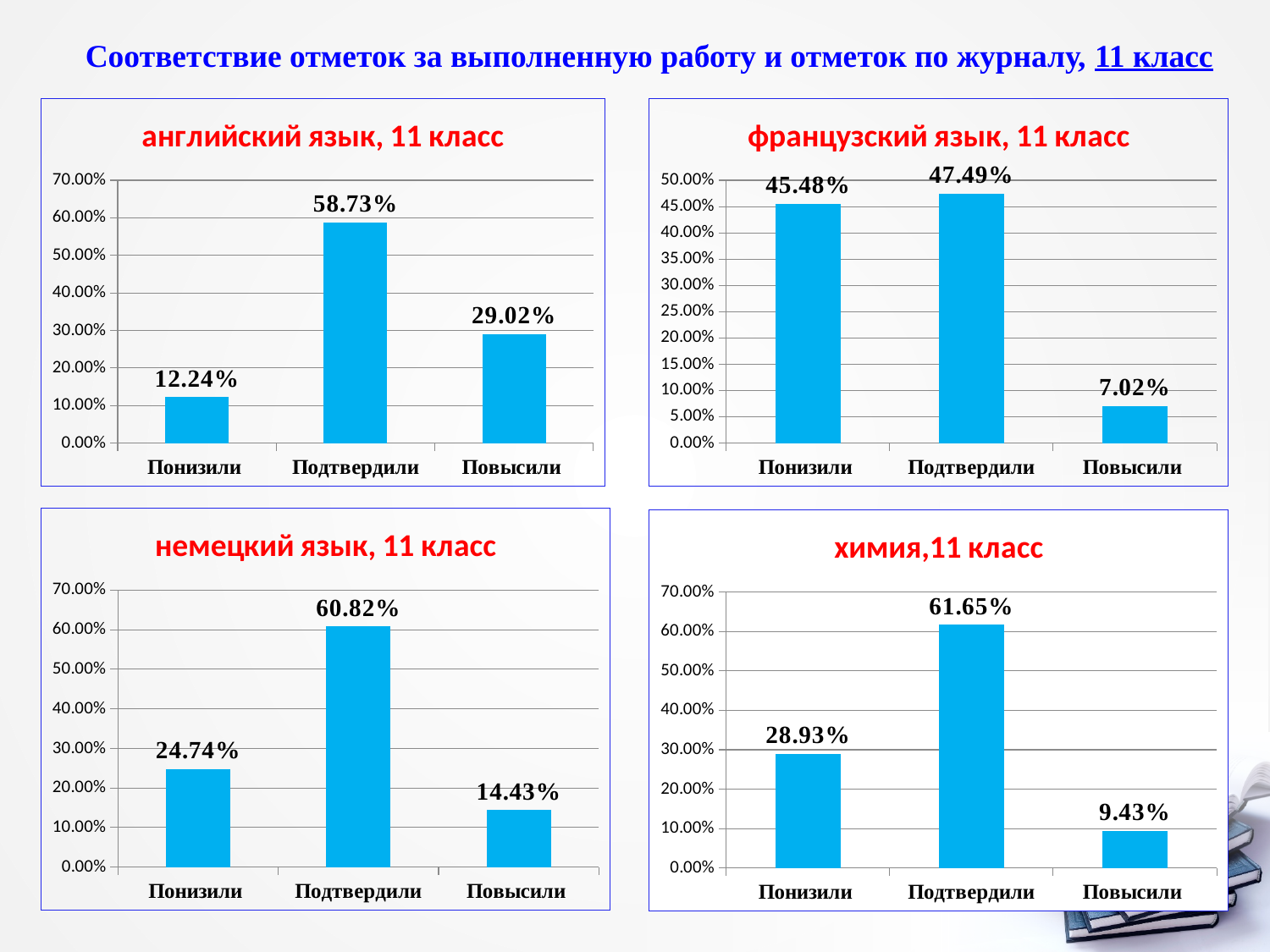
In the chart titled "французский язык, 11 класс", what is the difference between Подтвердили and Понизили? 2.01% How many charts are shown on the slide? 4 In the chart titled "английский язык, 11 класс", is the value for Повысили greater or less than 20.00%? greater In the chart titled "французский язык, 11 класс", what is the value for Повысили? 7.02% In the chart titled "химия,11 класс", what is the difference between Понизили and Повысили? 19.50% In the chart titled "химия,11 класс", which category has the highest value? Подтвердили In the chart titled "немецкий язык, 11 класс", which is larger, Понизили or Повысили? Понизили In the chart titled "английский язык, 11 класс", what is the value for Подтвердили? 58.73% How many categories are shown in the chart titled "французский язык, 11 класс"? 3 What kind of chart is the chart titled "химия,11 класс"? bar chart In the chart titled "немецкий язык, 11 класс", what is the value for Понизили? 24.74% In the chart titled "английский язык, 11 класс", which category has the lowest value? Понизили